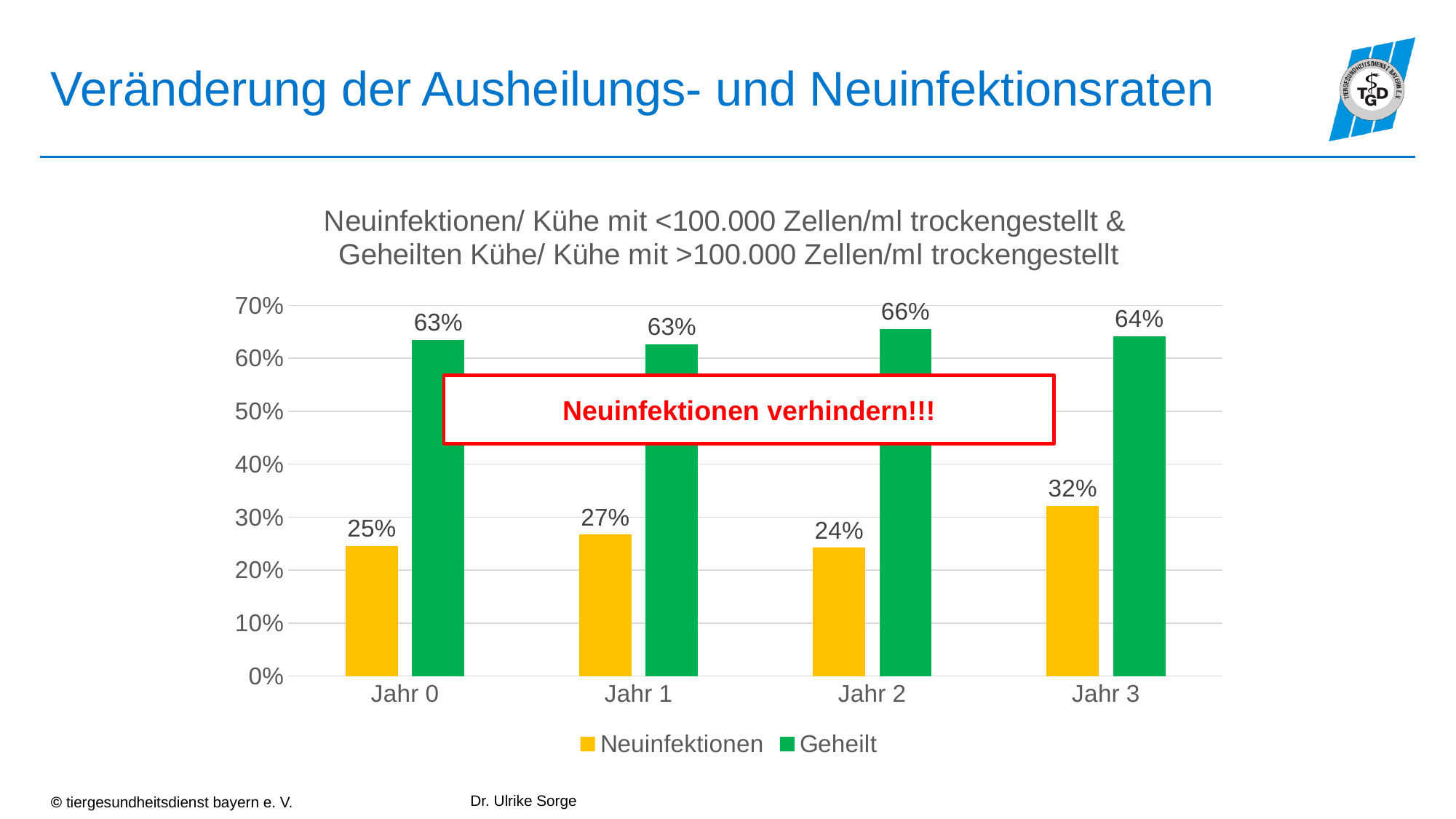
What kind of chart is shown on the slide? Bar chart What is the Neuinfektionen value for Jahr 3? 32% What is the Geheilt value for Jahr 1? 63% How many year categories are shown on the x axis? 4 In which year is the Geheilt value highest? Jahr 2 What is the Geheilt value for Jahr 2? 66% What is the difference between the Geheilt and Neuinfektionen values for Jahr 3? 32% How many series does the legend list? 2 In which year is the Neuinfektionen value highest? Jahr 3 In which year is the Neuinfektionen value lowest? Jahr 2 Which is larger for Jahr 1: the Neuinfektionen value or the Geheilt value? Geheilt What is the Neuinfektionen value for Jahr 0? 25%